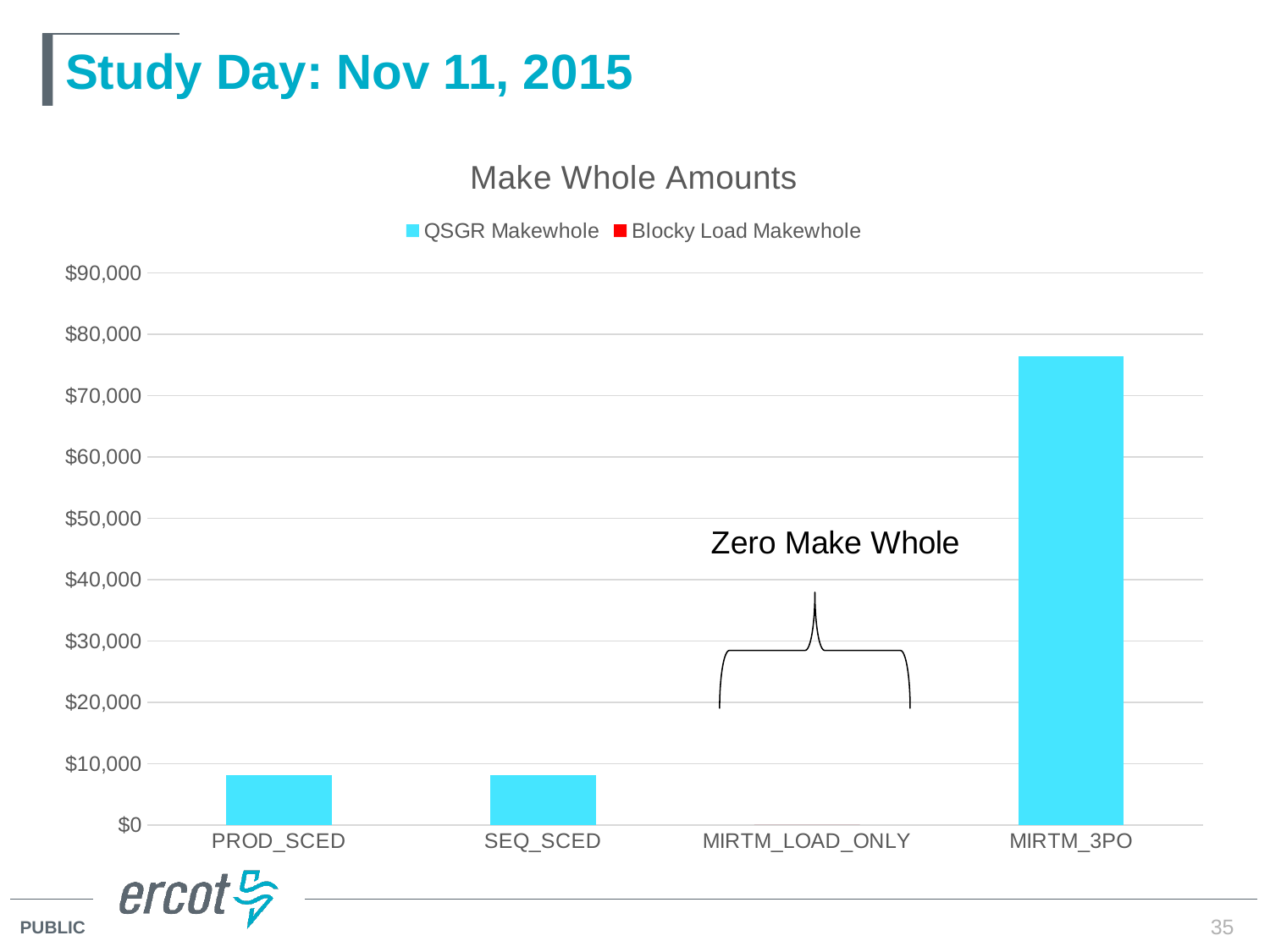
What is the title of the chart? Make Whole Amounts What kind of chart is shown on the slide? Bar chart Which category is annotated with the text 'Zero Make Whole'? MIRTM_LOAD_ONLY Is the value for SEQ_SCED greater or less than $10,000? less Which is larger, the value for MIRTM_3PO or the value for PROD_SCED? MIRTM_3PO How many series does the legend of the Make Whole Amounts chart list? 2 Which category has the highest make whole amount? MIRTM_3PO How many categories are shown on the x axis of the Make Whole Amounts chart? 4 Is the value for MIRTM_3PO greater or less than $80,000? less Is the value for PROD_SCED greater or less than $10,000? less Which category has the lowest make whole amount? MIRTM_LOAD_ONLY